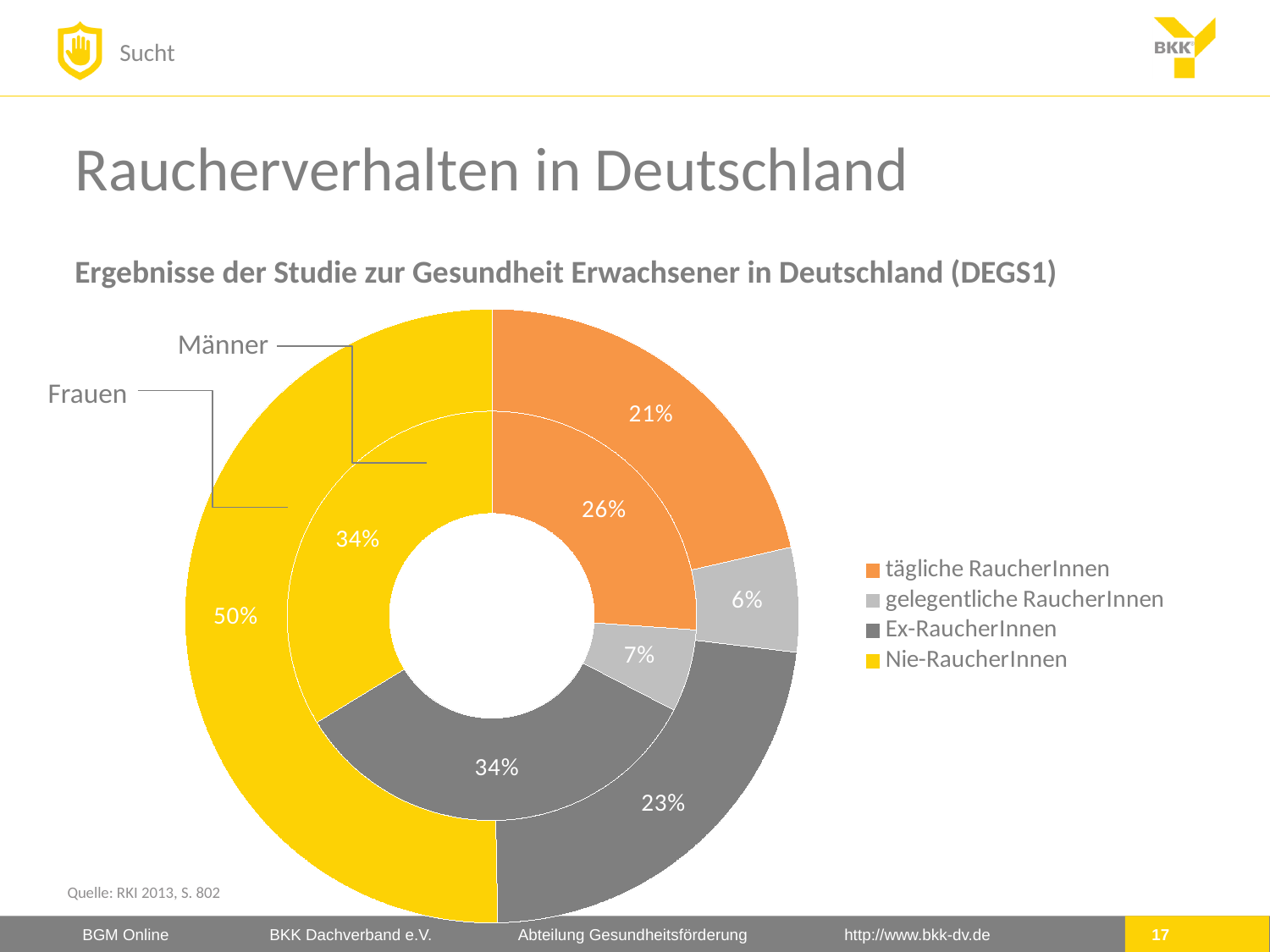
What is the share of tägliche RaucherInnen among Männer (inner ring)? 26% What is the difference between the Nie-RaucherInnen share for Frauen and for Männer? 16% What is the share of Ex-RaucherInnen among Männer (inner ring)? 34% How many series does the legend list? 4 What kind of chart is shown on the slide? Doughnut chart What is the share of Nie-RaucherInnen among Frauen (outer ring)? 50% What is the share of gelegentliche RaucherInnen among Frauen (outer ring)? 6% Which category has the smallest share in the Männer (inner) ring? gelegentliche RaucherInnen Which is larger: the Ex-RaucherInnen share for Männer or for Frauen? Männer Which ring of the chart represents Frauen, the inner or the outer? Outer What is the share of tägliche RaucherInnen among Frauen (outer ring)? 21% Which category has the largest share in the Frauen (outer) ring? Nie-RaucherInnen